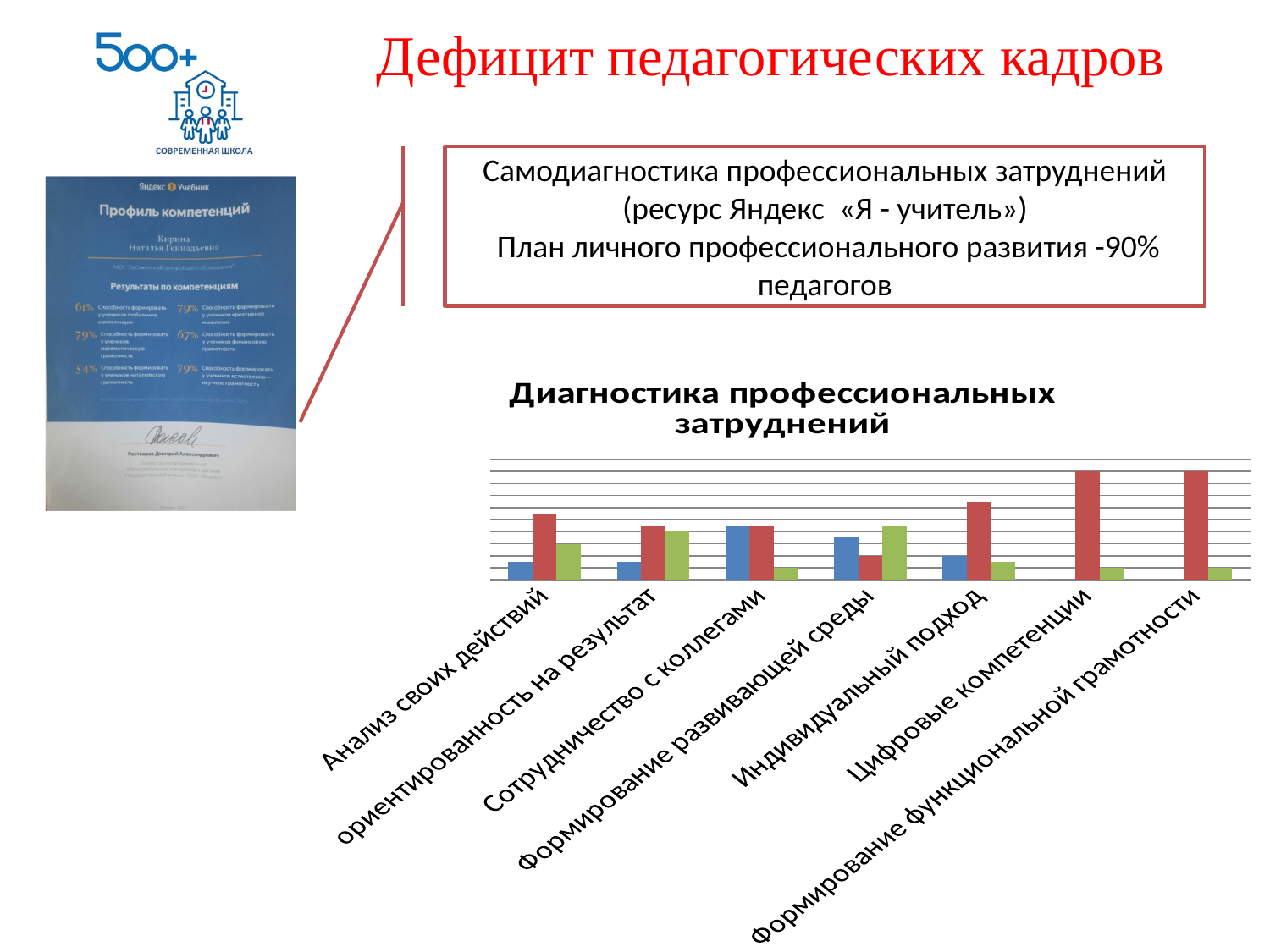
How many categories in the chart show a visible blue bar? 5 How many different bar colours are used in the chart? 3 Which category has the tallest blue bar? Сотрудничество с коллегами In the category "Анализ своих действий", which bar is taller, the red one or the blue one? red In the category "Формирование развивающей среды", which bar is taller, the green one or the red one? green Which category has a taller red bar, "Индивидуальный подход" or "Анализ своих действий"? Индивидуальный подход What kind of chart is shown under the title "Диагностика профессиональных затруднений"? bar chart What is the title of the chart on the slide? Диагностика профессиональных затруднений How many categories are shown on the x axis of the chart? 7